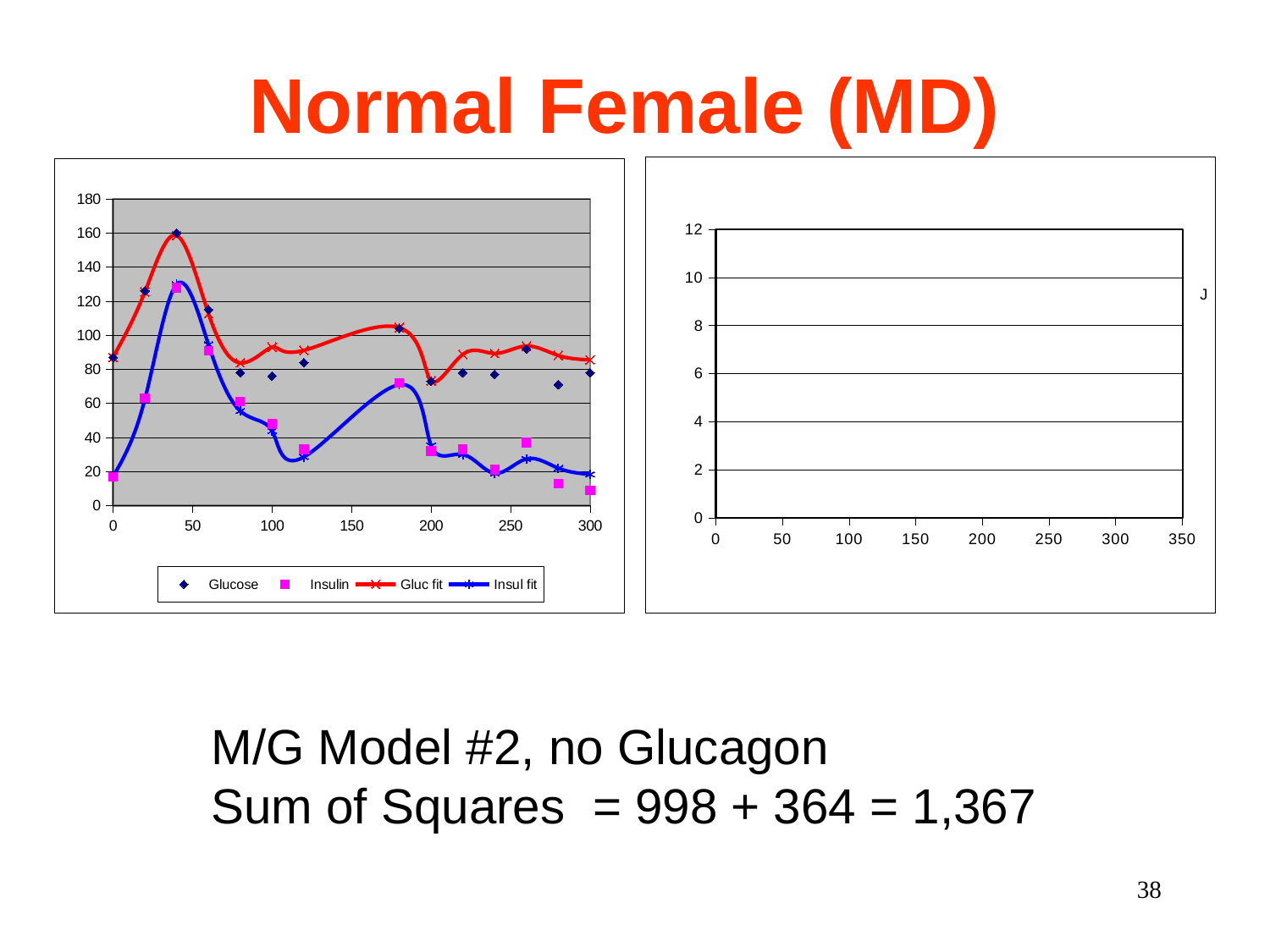
On the left chart, is the Insulin value at x = 0 greater or less than 40? less On the left chart, is the Glucose value at x = 40 greater or less than 140? greater On the left chart, what are the four legend entries? Glucose, Insulin, Gluc fit, Insul fit On the left chart, does the Glucose series rise or fall between x = 40 and x = 80? fall On the left chart, how many series does the legend list? 4 On the left chart, at which x value does Insulin reach its highest point? 40 On the left chart, which is larger at x = 0, Glucose or Insulin? Glucose On the left chart, is the Insulin value at x = 300 greater or less than 20? less On the right chart, what is the highest value shown on the y axis? 12 On the left chart, does the Insulin series rise or fall between x = 0 and x = 40? rise On the left chart, at which x value does Glucose reach its highest point? 40